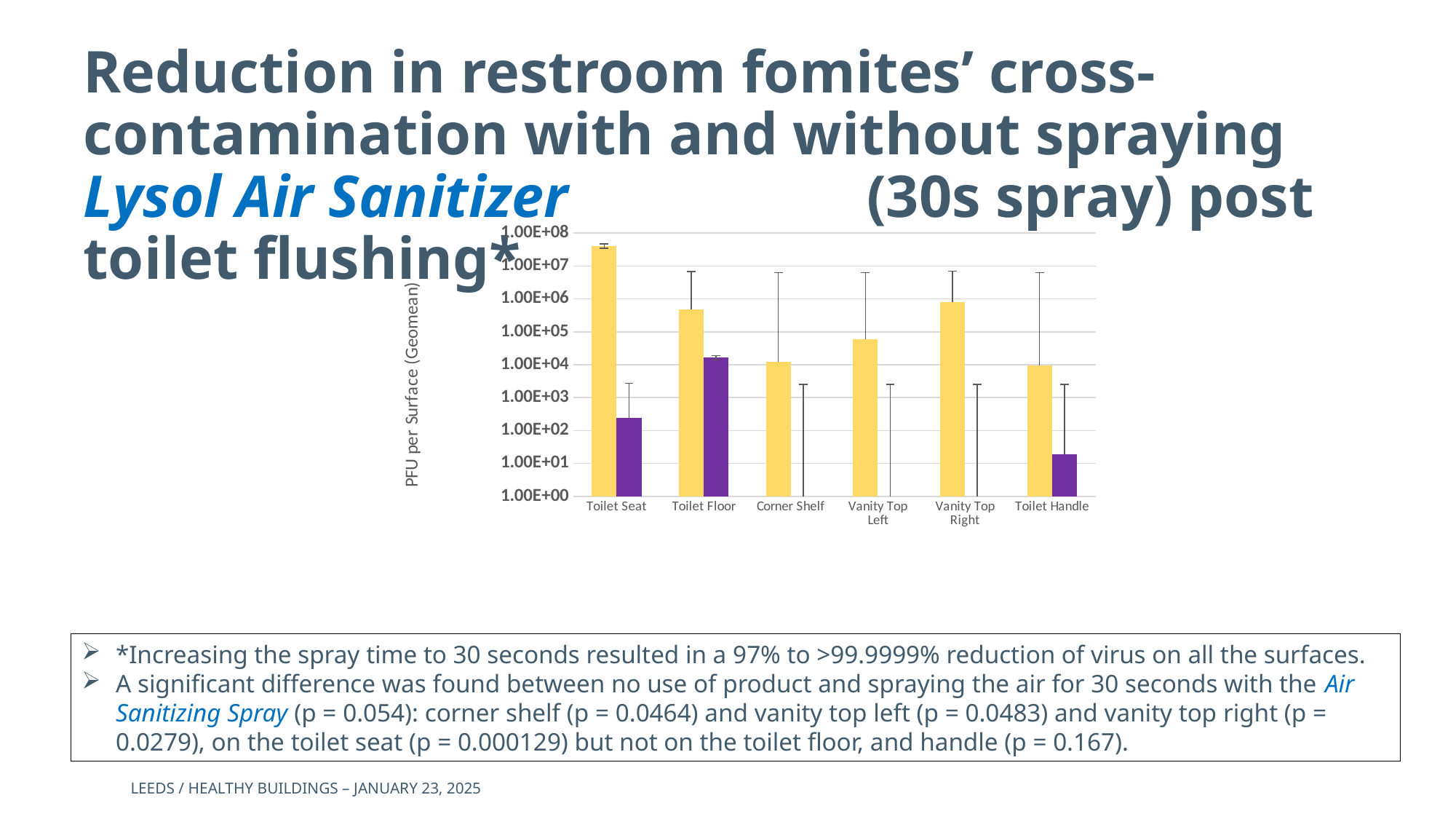
Which is larger, the yellow bar for Vanity Top Right or the yellow bar for Vanity Top Left? Vanity Top Right Is the yellow bar for Vanity Top Right greater or less than 1.00E+05? greater Is the purple bar for Toilet Handle greater or less than 1.00E+02? less What kind of chart is shown on the slide? bar chart Which is larger, the purple bar for Toilet Floor or the purple bar for Toilet Seat? Toilet Floor What is the label of the chart's vertical axis? PFU per Surface (Geomean) Which surface has the highest purple bar in the chart? Toilet Floor Is the yellow bar for Toilet Seat greater or less than 1.00E+07? greater How many surface categories are shown on the x axis of the chart? 6 Which surface has the highest yellow bar in the chart? Toilet Seat